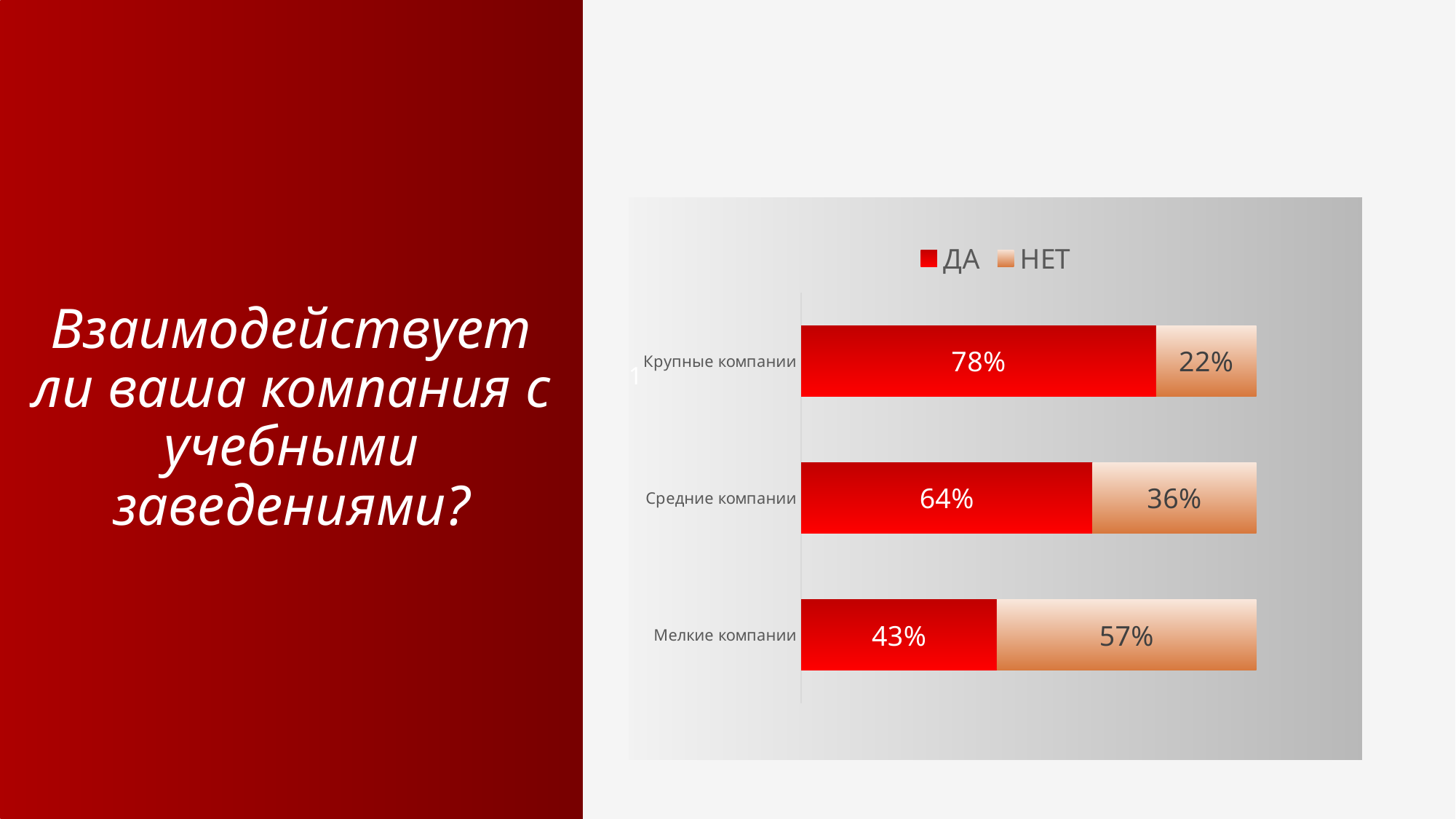
Which company category has the highest share of ДА answers? Крупные компании Which company category has the lowest share of ДА answers? Мелкие компании Which is larger: the НЕТ share for medium companies or the НЕТ share for small companies? Мелкие компании (57%) What percentage of large companies (Крупные компании) answered ДА? 78% How many company categories are shown in the chart? 3 How many series does the legend list? 2 What are the two legend entries of the chart? ДА and НЕТ What percentage of large companies (Крупные компании) answered НЕТ? 22% What percentage of small companies (Мелкие компании) answered ДА? 43% What is the difference between the ДА share for large companies and the ДА share for small companies? 35% What kind of chart is shown on the slide? Stacked bar chart What percentage of medium companies (Средние компании) answered НЕТ? 36%